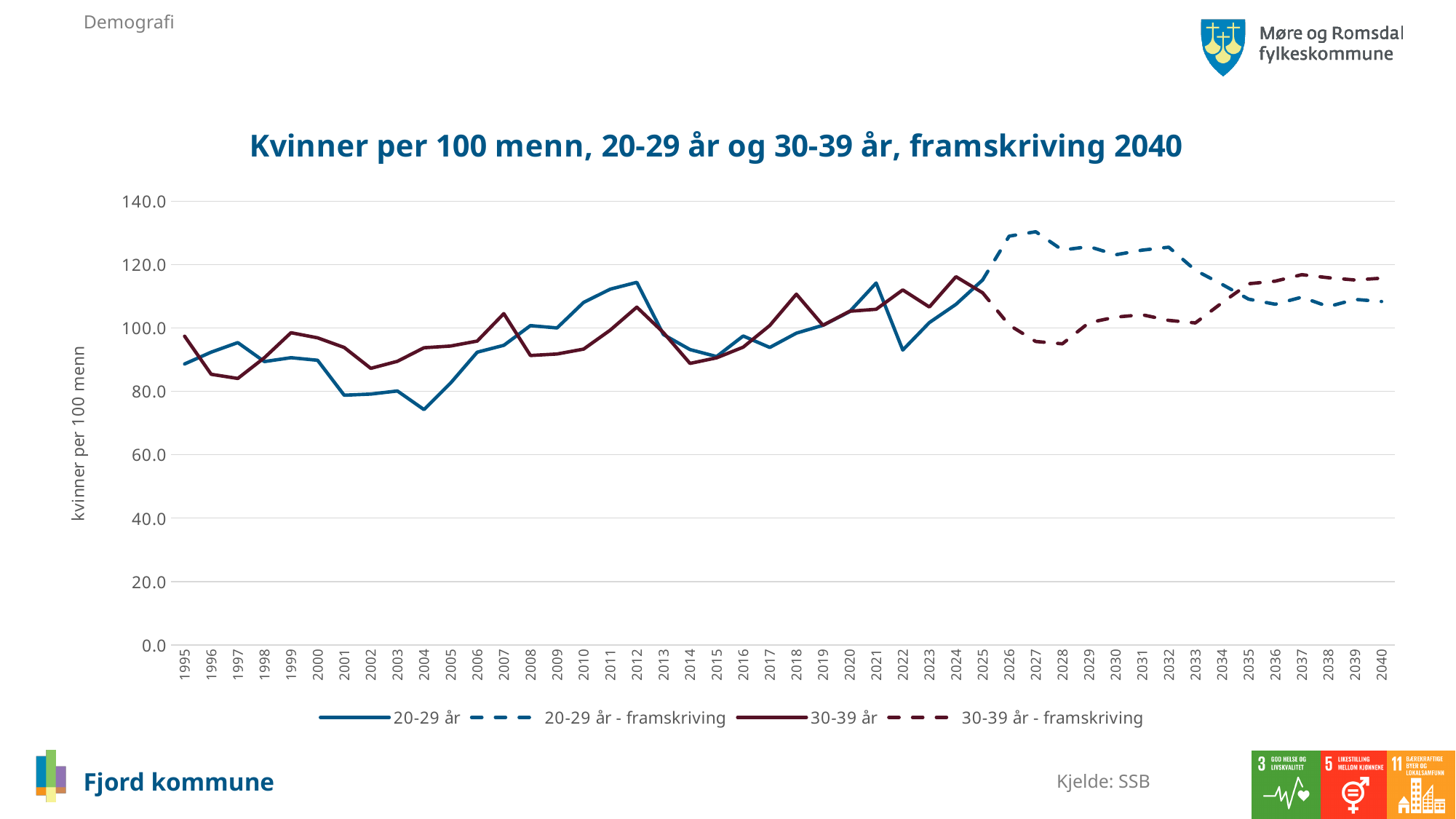
What kind of chart is shown on the slide? line chart Is the value for 30-39 år - framskriving in 2028 greater or less than 100? less Is the value for 30-39 år in 1997 greater or less than 100? less In 2027, which series is higher: 20-29 år - framskriving or 30-39 år - framskriving? 20-29 år - framskriving How many series does the legend list? 4 Does the 20-29 år - framskriving series rise or fall from 2027 to 2040? fall What is the label on the y axis? kvinner per 100 menn Is the value for 20-29 år in 2012 greater or less than 100? greater In which year does the 20-29 år series reach its lowest value? 2004 In 2004, which series is higher: 20-29 år or 30-39 år? 30-39 år